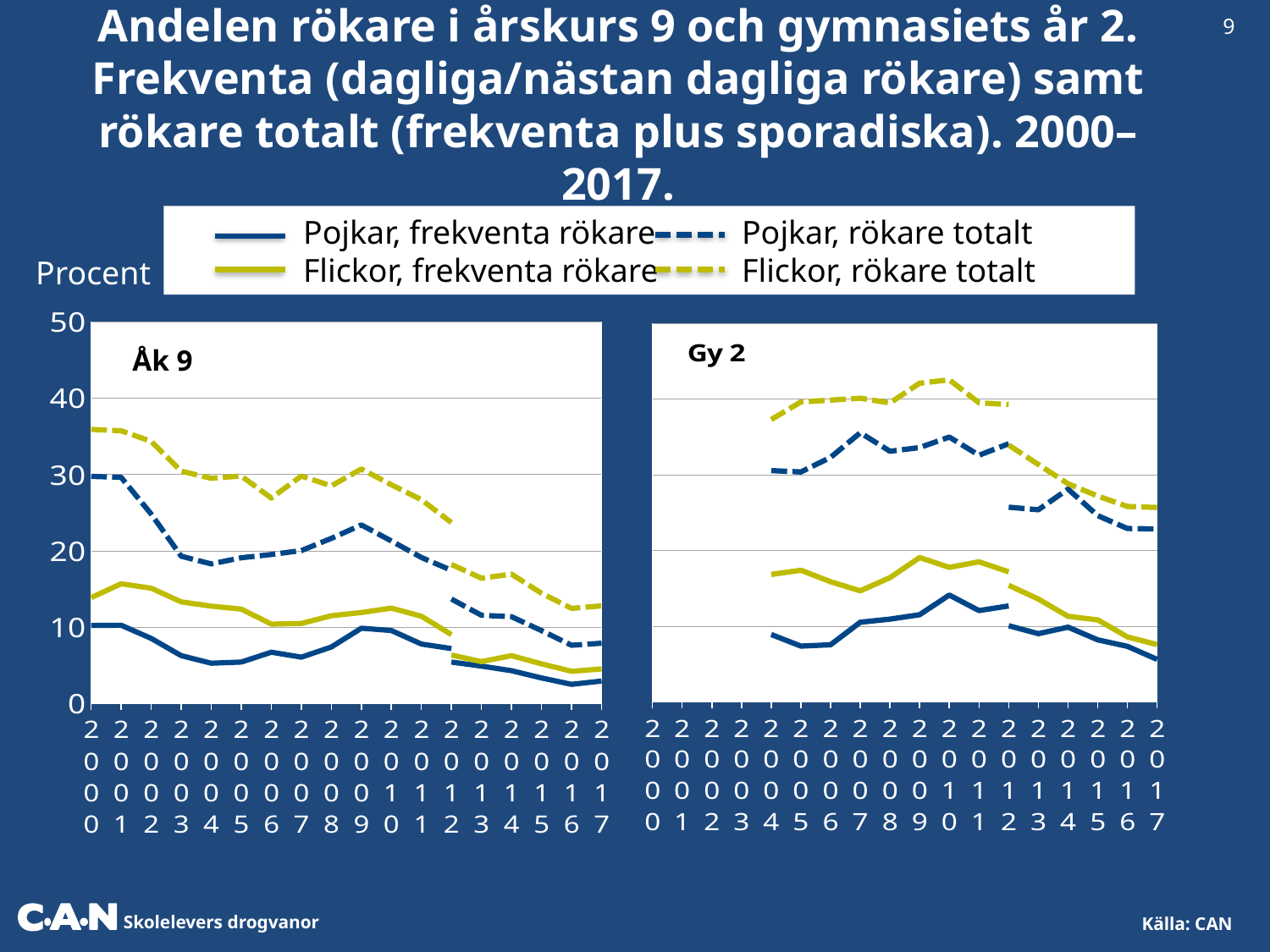
In the Gy 2 chart, is the value for Pojkar, rökare totalt in 2007 greater or less than 30? greater What type of chart is used on this slide? Line chart In the Gy 2 chart, does the Pojkar, frekventa rökare series rise or fall overall from 2004 to 2017? Fall How many series does the legend list? 4 In the Gy 2 chart, is the value for Flickor, frekventa rökare in 2004 greater or less than 20? less How many years are labelled on the x axis of the Åk 9 chart? 18 In the Åk 9 chart, does the Flickor, rökare totalt series rise or fall from 2000 to 2017? Fall In the Åk 9 chart, is the value for Pojkar, frekventa rökare in 2017 greater or less than 10? less According to the legend, which line style is used for the 'rökare totalt' series? Dashed In the Åk 9 chart, which series has the highest value in 2000? Flickor, rökare totalt In the Gy 2 chart, which is higher in 2017: Flickor, rökare totalt or Pojkar, rökare totalt? Flickor, rökare totalt